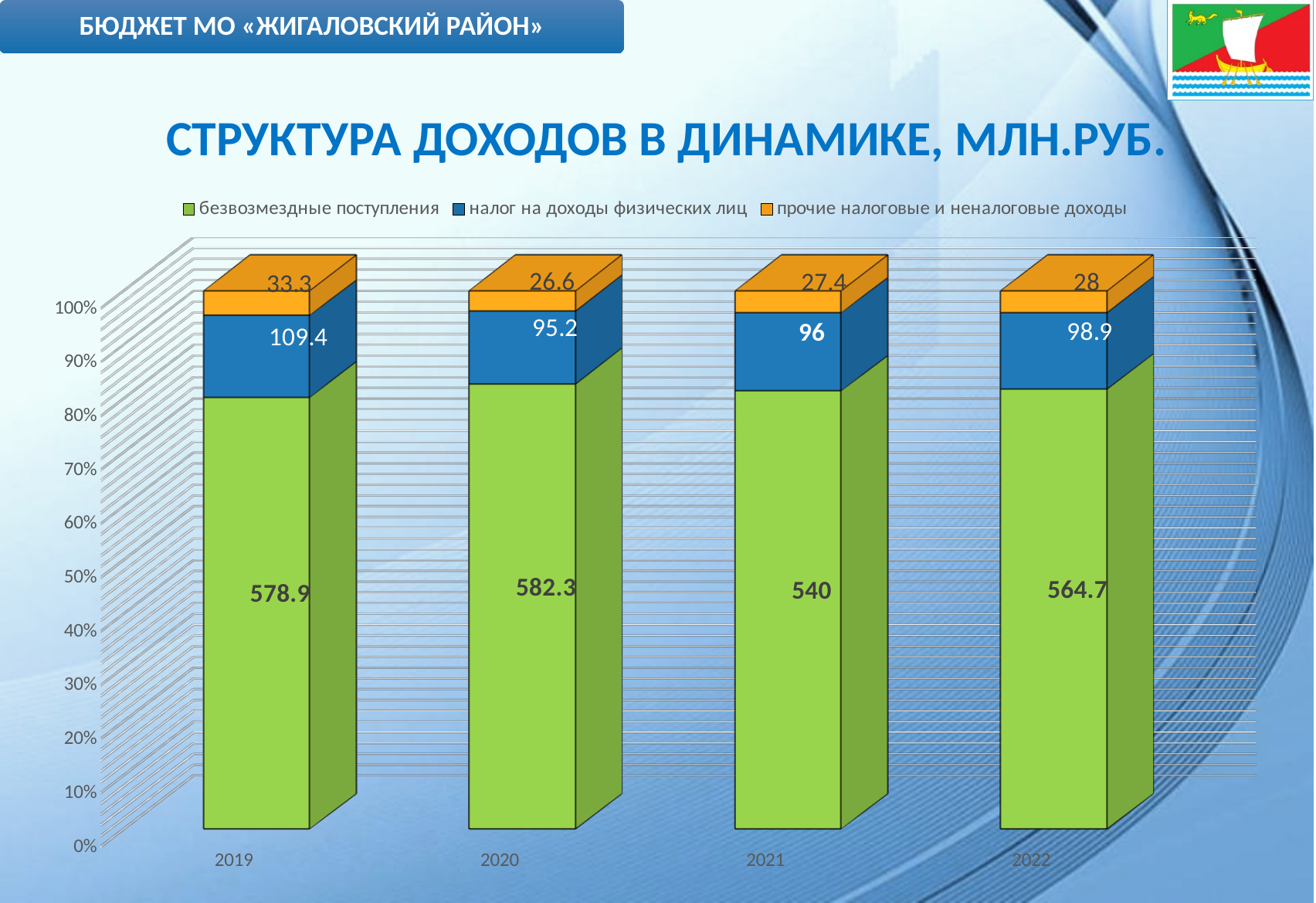
Which is larger: безвозмездные поступления in 2022 or in 2021? 2022 What is the value of безвозмездные поступления for 2019? 578.9 What kind of chart is shown on the slide? Stacked bar chart How many years are shown on the x axis? 4 In which year is прочие налоговые и неналоговые доходы the lowest? 2020 What is the value of безвозмездные поступления for 2021? 540 What is the value of налог на доходы физических лиц for 2020? 95.2 What is the difference between налог на доходы физических лиц in 2019 and in 2022? 10.5 In which year is безвозмездные поступления the highest? 2020 How many series does the legend list? 3 What is the value of прочие налоговые и неналоговые доходы for 2022? 28 What is the total of the stacked bar for 2021? 663.4